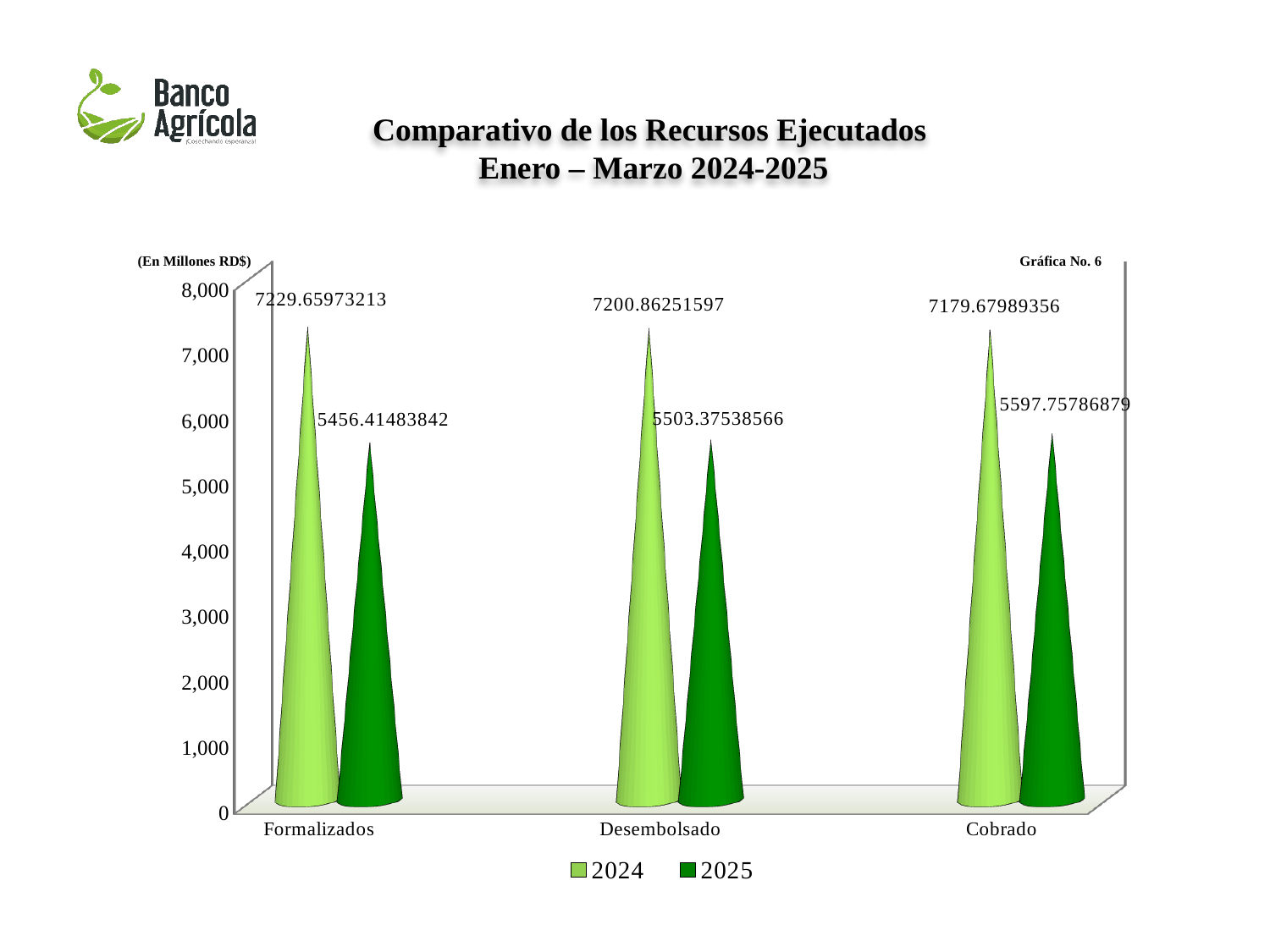
What is the difference between the 2024 and 2025 values for Cobrado? 1581.92202477 What is the value for Cobrado in the 2024 series? 7179.67989356 Which category has the lowest value in the 2025 series? Formalizados What is the value for Formalizados in the 2024 series? 7229.65973213 Which category has the highest value in the 2025 series? Cobrado What is the difference between the 2024 and 2025 values for Formalizados? 1773.24489371 How many series does the legend list? 2 Which category has the highest value in the 2024 series? Formalizados What kind of chart is shown on the slide? Bar chart What is the value for Desembolsado in the 2025 series? 5503.37538566 Which is larger for Desembolsado, the 2024 value or the 2025 value? 2024 How many categories are shown on the x axis? 3